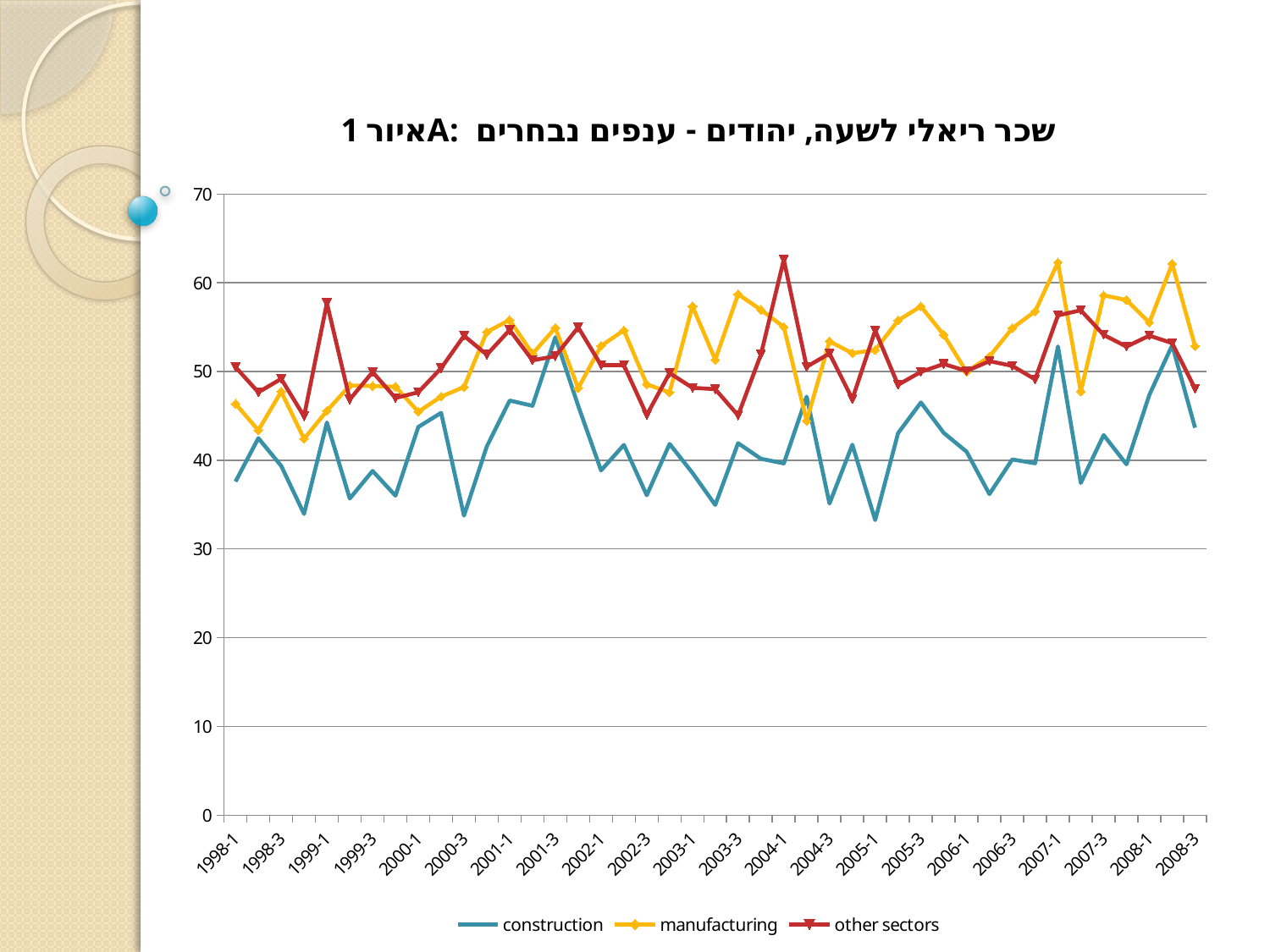
Which series is drawn in red with triangle markers? other sectors Is the value for construction at 2005-1 greater or less than 40? less Is the value for other sectors at 2004-1 greater or less than 60? greater What kind of chart is shown on the slide? line chart Which series has the lowest value at 2001-1? construction At 2004-1, which is larger: other sectors or manufacturing? other sectors Is the value for construction at 1998-1 greater or less than 40? less Which series is drawn as the blue line? construction How many series does the legend list? 3 Does the other sectors line rise or fall from 2003-3 to 2004-1? rise